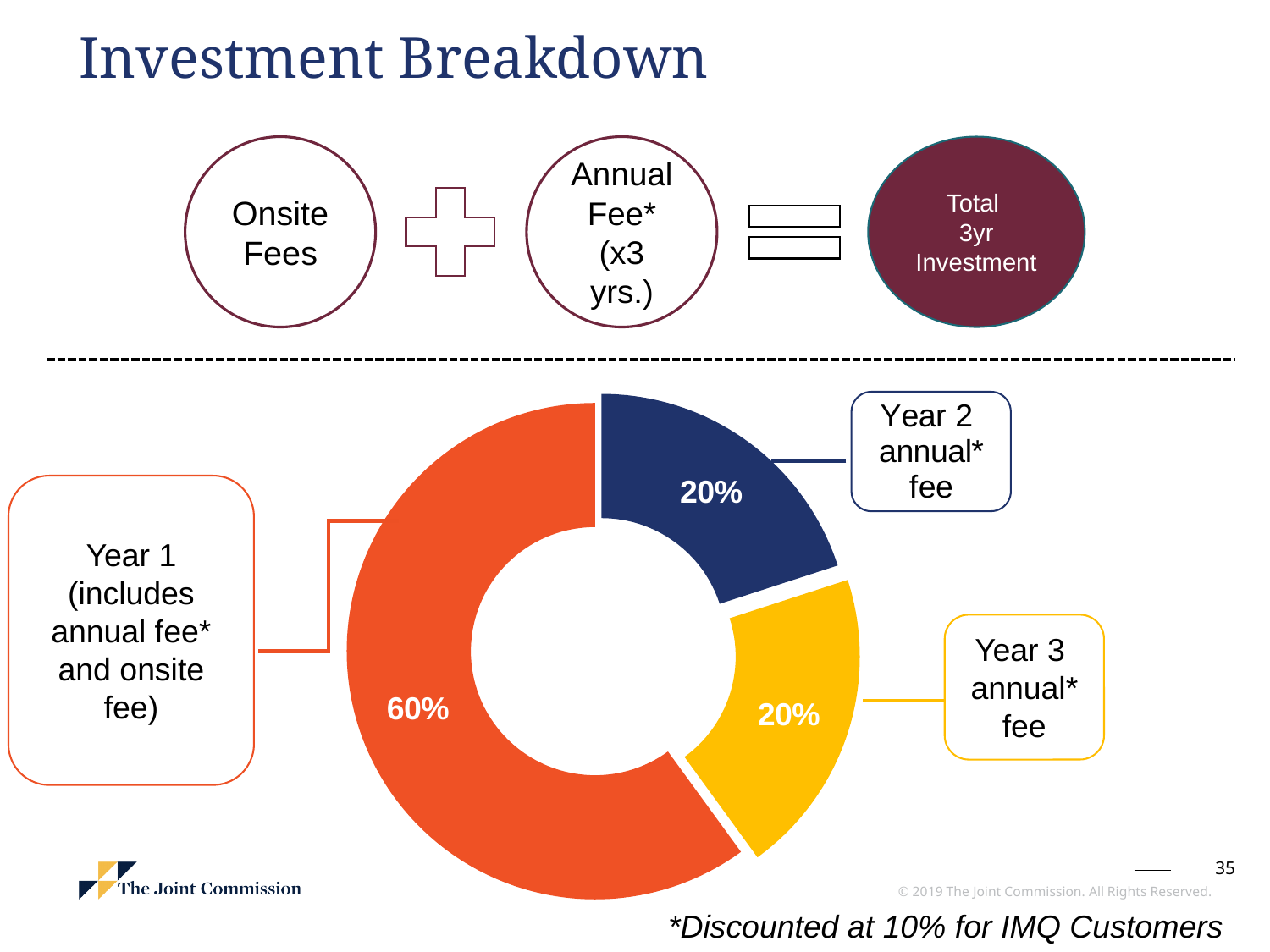
Which segment of the donut chart is the largest? Year 1 (includes annual fee and onsite fee) What colour is the Year 3 annual fee segment of the donut chart? Yellow What is the title of the slide containing the donut chart? Investment Breakdown What share of the total 3-year investment does the Year 2 annual fee represent? 20% What share of the total 3-year investment does the Year 3 annual fee represent? 20% What kind of chart is shown on the slide? Donut (pie) chart What is the combined share of the Year 2 and Year 3 annual fees? 40% How many segments does the donut chart have? 3 Is the Year 1 share greater or less than 50%? greater Which is larger: the Year 1 share or the Year 3 annual fee share? Year 1 What share of the total 3-year investment does Year 1 (includes annual fee and onsite fee) represent? 60% What is the difference in percentage points between the Year 1 share and the Year 2 annual fee share? 40%